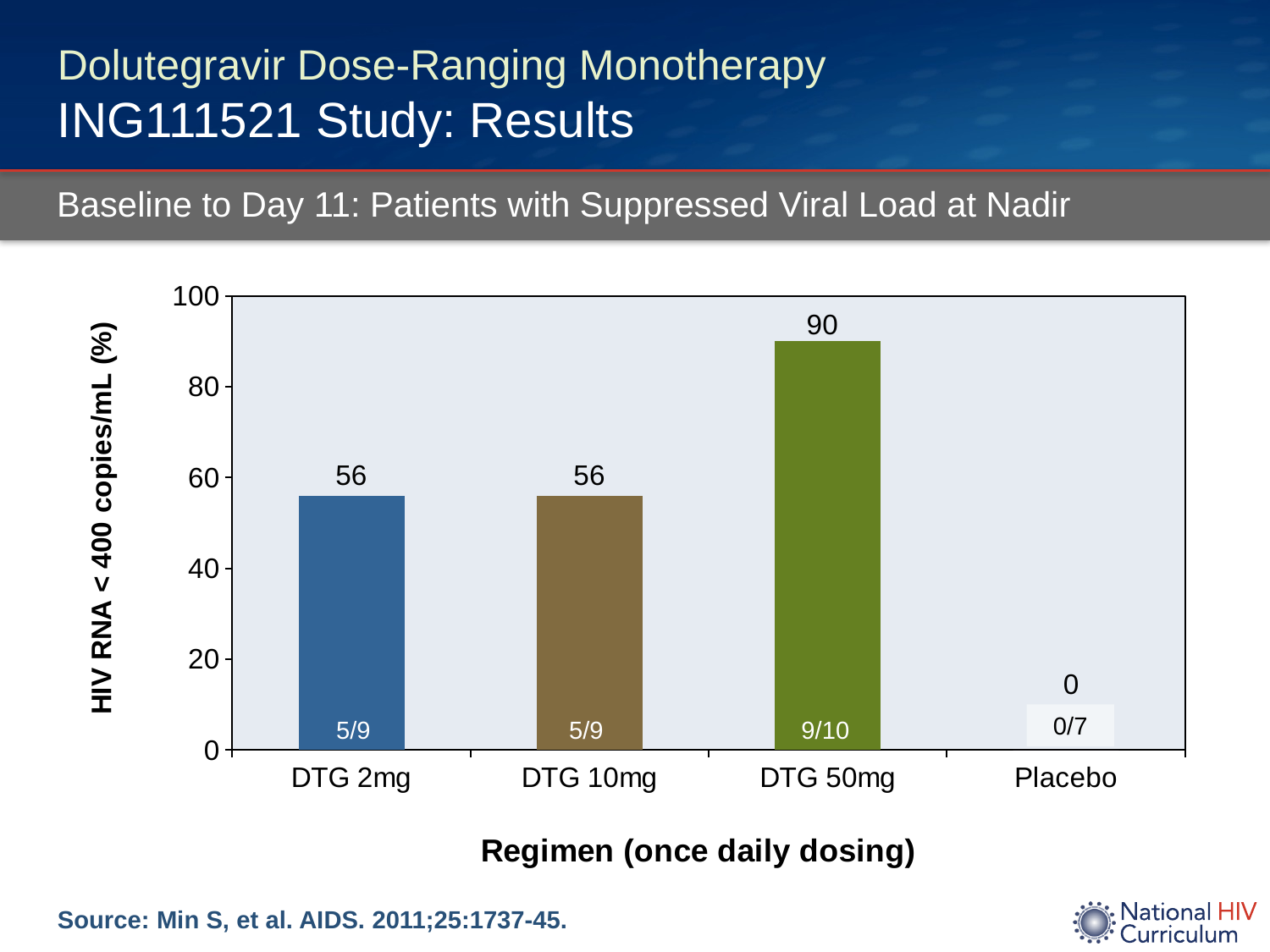
What is the value for DTG 50mg? 90 What fraction of patients is shown inside the DTG 50mg bar? 9/10 What fraction of patients is shown inside the Placebo bar? 0/7 What is the value for Placebo? 0 How many regimens are shown on the x axis? 4 Which is larger, the value for DTG 50mg or the value for DTG 2mg? DTG 50mg What kind of chart is shown? Bar chart Which regimen has the highest value? DTG 50mg What is the value for DTG 2mg? 56 What is the x-axis title of the chart? Regimen (once daily dosing) What is the difference between the values for DTG 50mg and DTG 10mg? 34 Which regimen has the lowest value? Placebo